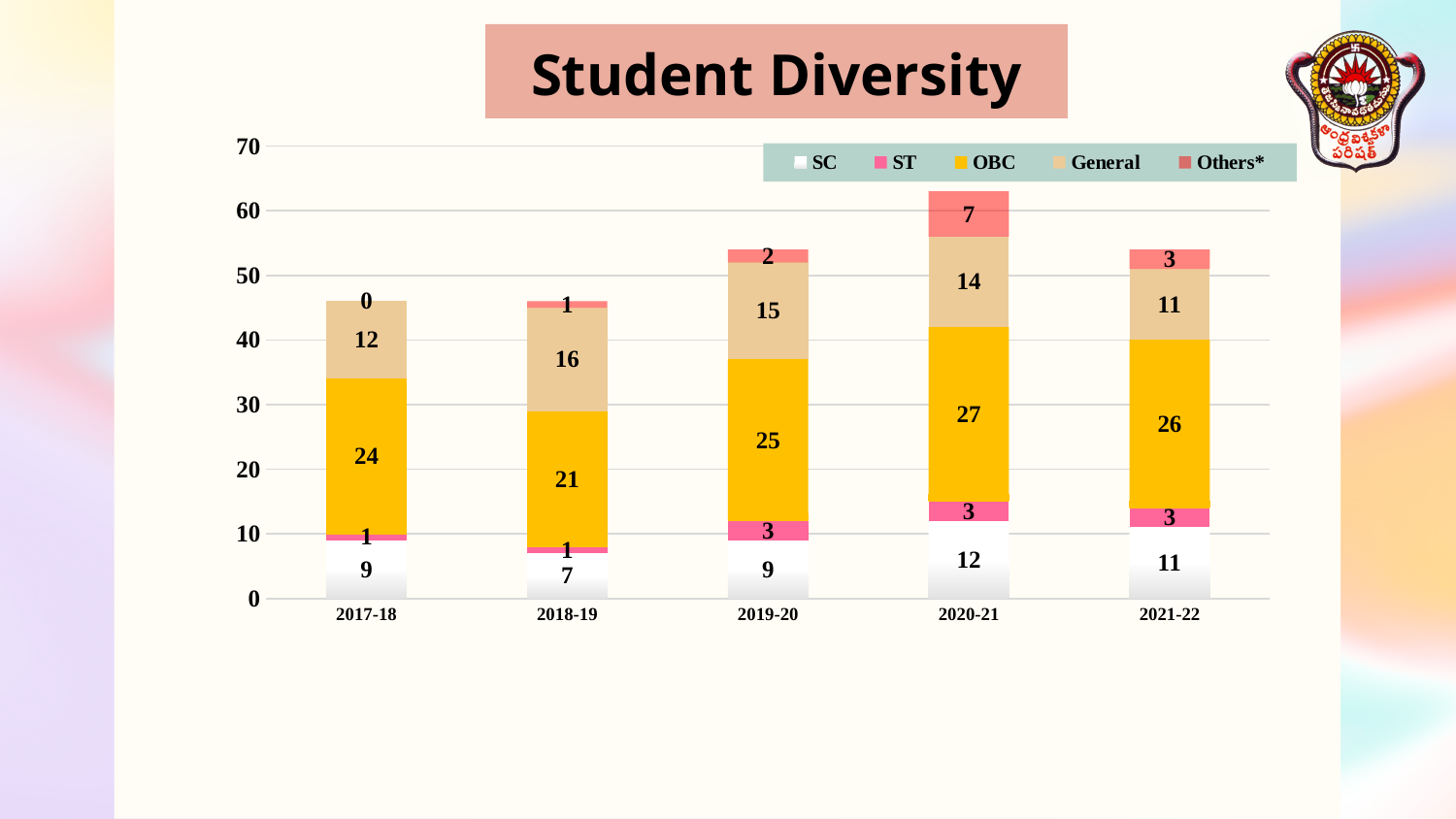
Which year has the highest OBC value? 2020-21 What is the Others* value for 2017-18? 0 What is the OBC value for 2020-21? 27 Which year has the lowest SC value? 2018-19 What is the title of the slide containing the chart? Student Diversity What is the total of the stacked bar for 2020-21? 63 What is the difference between the General values for 2019-20 and 2021-22? 4 What is the General value for 2018-19? 16 How many academic years are shown on the x axis? 5 How many series does the legend list? 5 What type of chart is shown on the slide? Stacked bar chart Which is larger, the SC value for 2020-21 or the SC value for 2021-22? 2020-21